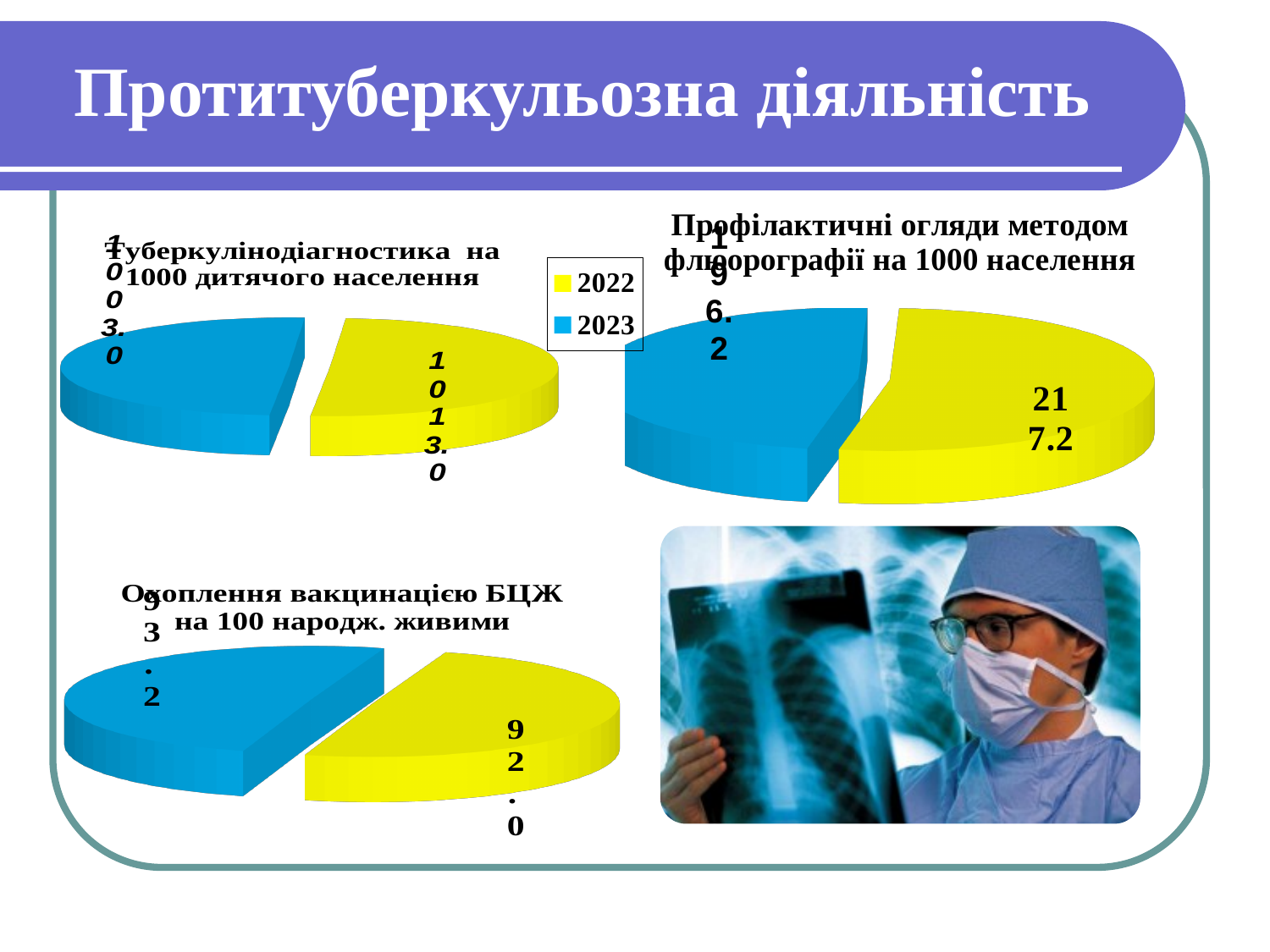
In the chart 'Профілактичні огляди методом флюорографії на 1000 населення', what is the difference between the 2022 and 2023 values? 21.0 In the chart 'Профілактичні огляди методом флюорографії на 1000 населення', what is the value for 2023? 196.2 In the chart 'Туберкулінодіагностика на 1000 дитячого населення', what is the value for 2023? 1003.0 In the chart 'Профілактичні огляди методом флюорографії на 1000 населення', what is the value for 2022? 217.2 In the chart 'Туберкулінодіагностика на 1000 дитячого населення', what is the difference between the 2022 and 2023 values? 10.0 How many entries does the legend on the slide list? 2 What type of chart is used for 'Охоплення вакцинацією БЦЖ на 100 народж. живими'? Pie chart In the chart 'Туберкулінодіагностика на 1000 дитячого населення', what is the value for 2022? 1013.0 In the chart 'Профілактичні огляди методом флюорографії на 1000 населення', which year has the higher value? 2022